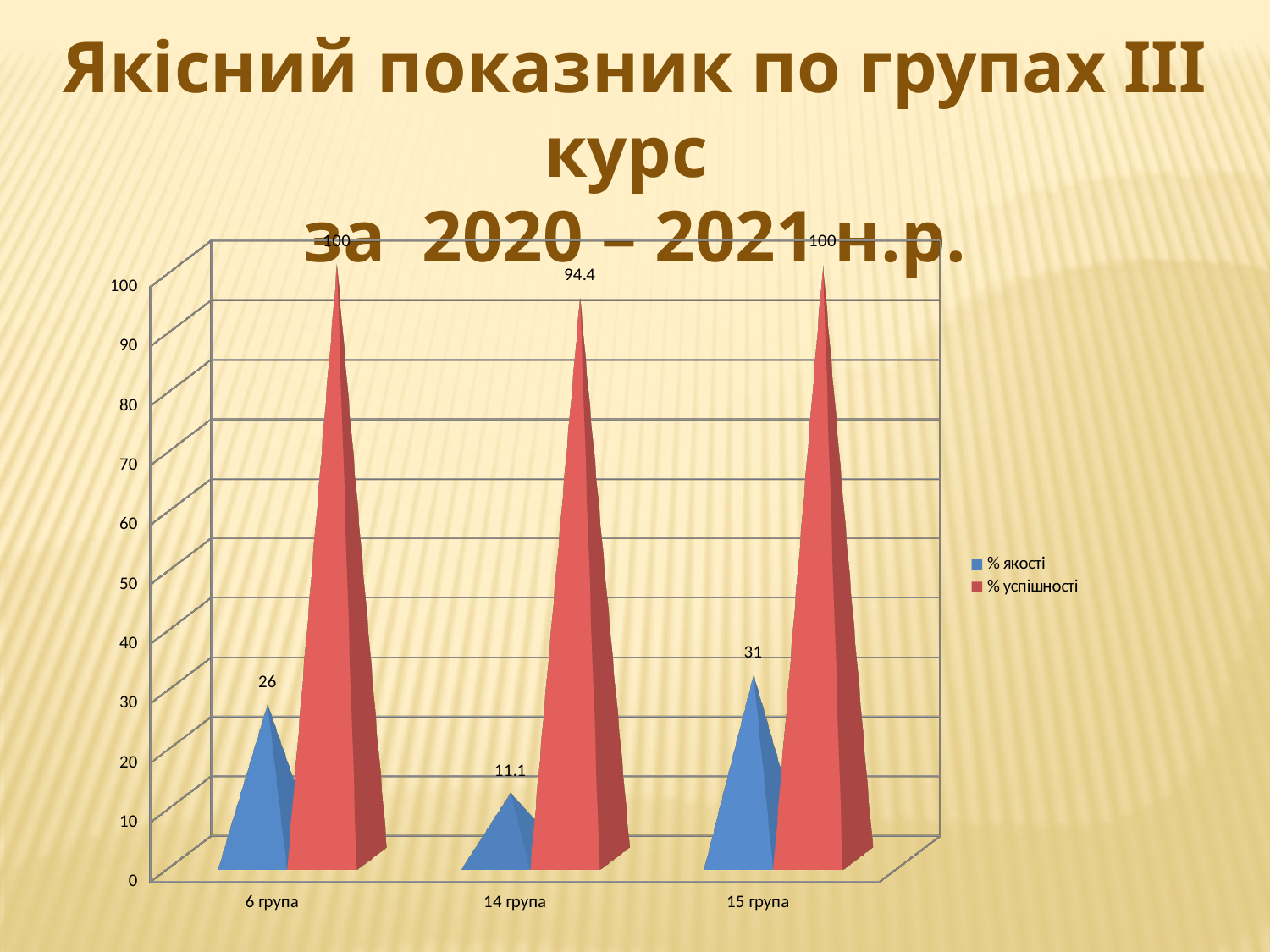
What is the difference between the % якості values for 15 група and 6 група? 5 Which group has the lowest % якості? 14 група Which group has the lowest % успішності? 14 група Which is larger, the % якості for 6 група or for 14 група? 6 група Which group has the highest % якості? 15 група Which series is shown in red? % успішності How many groups are shown on the x axis? 3 What is the % якості value for 15 група? 31 What is the % якості value for 6 група? 26 What is the % успішності value for 14 група? 94.4 What is the % успішності value for 15 група? 100 How many series does the legend list? 2